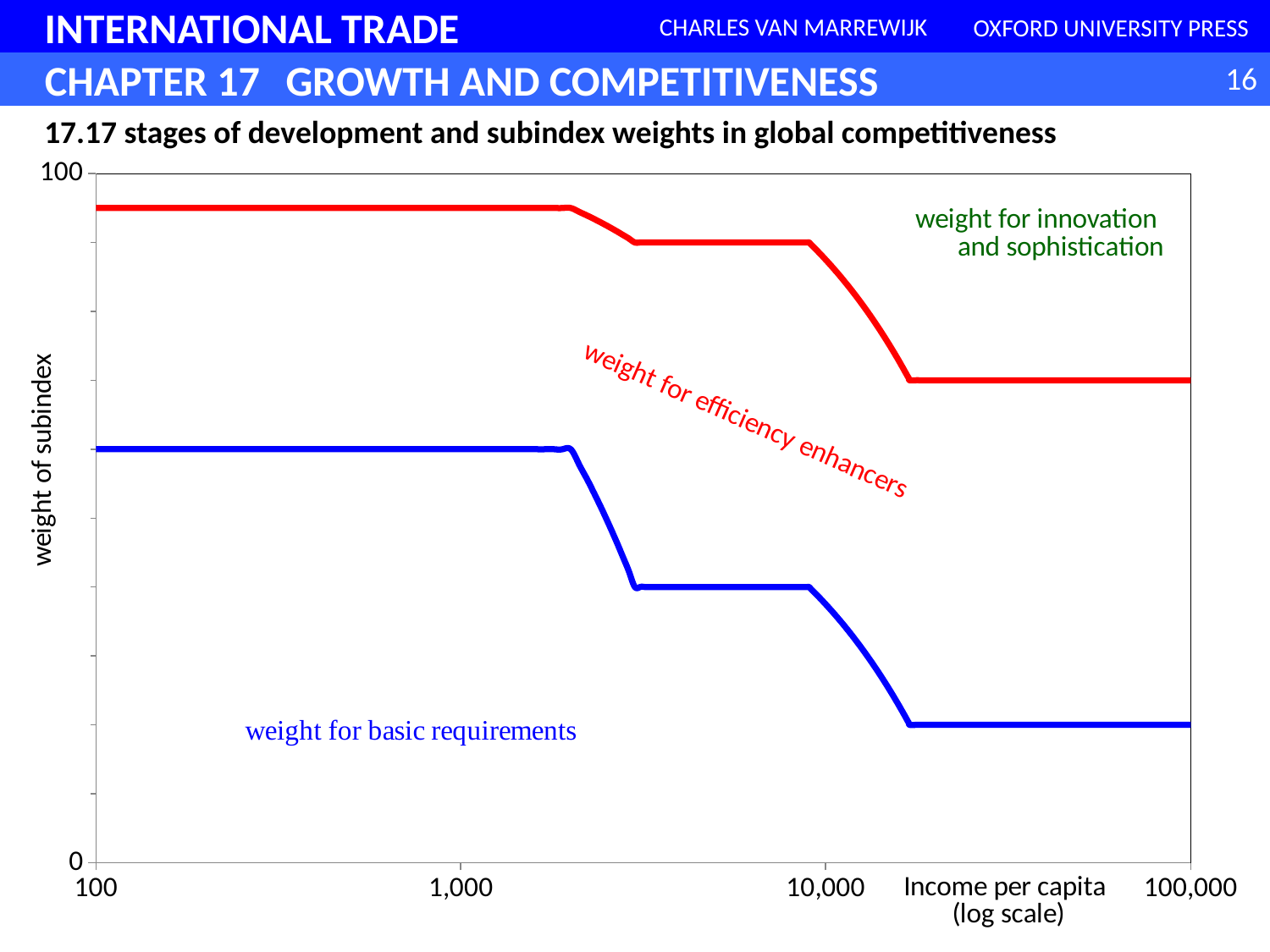
At an income per capita of 100,000, which line is higher, the red line or the blue line? the red line What is the title of the chart? 17.17 stages of development and subindex weights in global competitiveness Does the blue line (weight for basic requirements) rise or fall as income per capita increases? fall Between which two labelled x-axis values does the blue line first start to drop? between 1,000 and 10,000 Does the red line rise or fall as income per capita increases? fall What colour is the line labelled 'weight for basic requirements'? blue At an income per capita of 100, which line is higher, the red line or the blue line? the red line What kind of chart is shown on the slide? line chart What is the highest value labelled on the y axis? 100 How many lines are plotted on the chart? 2 How many labelled tick values are shown on the x axis? 4